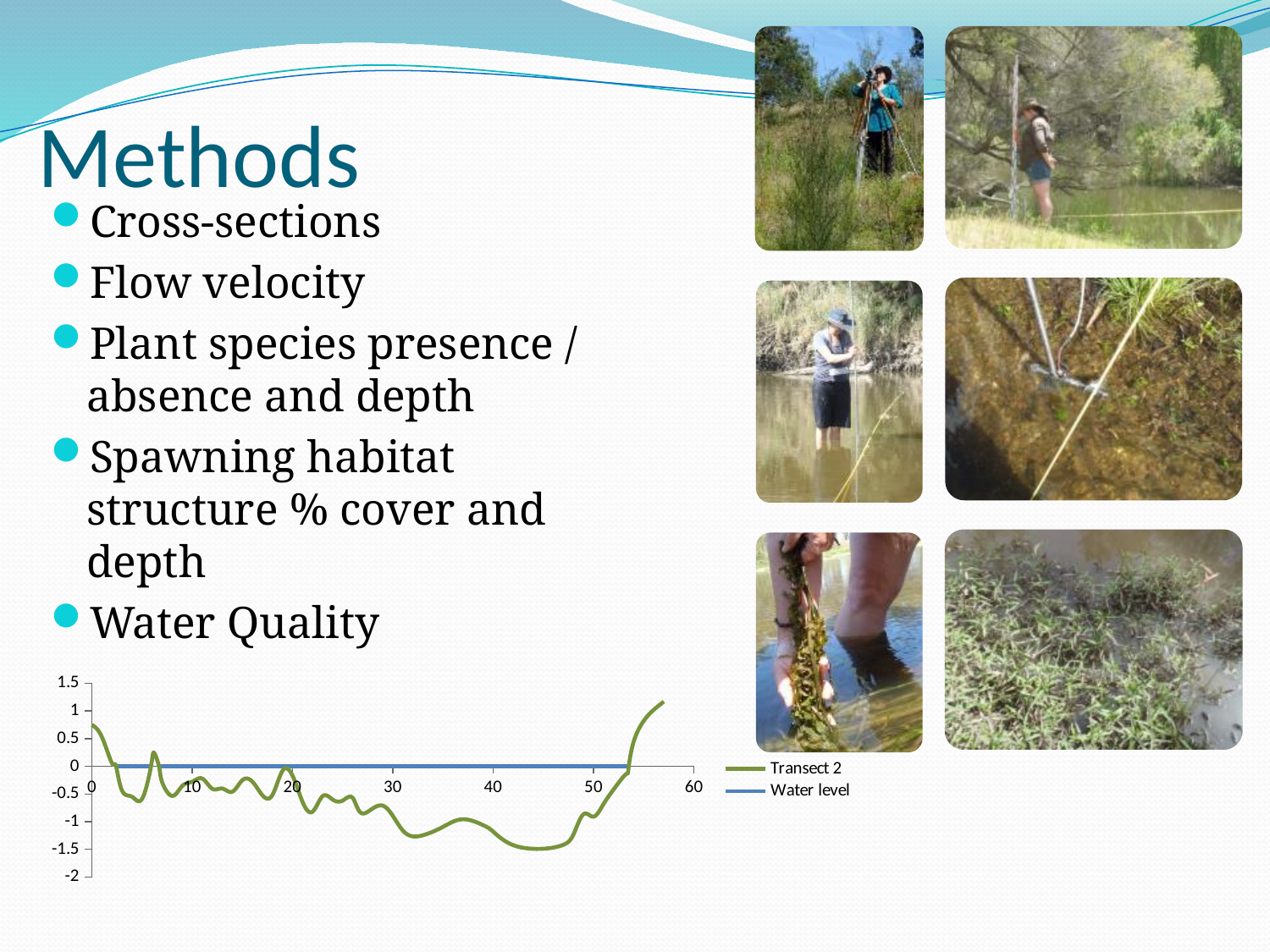
How many series does the legend of the chart list? 2 What colour is the Transect 2 line in the chart? green Is the Transect 2 value at x = 40 greater or less than -0.5? less Which series is higher at x = 40, Transect 2 or Water level? Water level At what value on the y axis does the Water level line sit? 0 What are the two series named in the chart legend? Transect 2 and Water level Is the lowest point of the Transect 2 line greater or less than -1? less Is the Transect 2 value at x = 0 greater or less than 0.5? greater Between x = 0 and x = 5, does the Transect 2 value rise or fall? fall Between x = 50 and the end of the line, does the Transect 2 value rise or fall? rise What kind of chart is shown at the bottom left of the slide? line chart